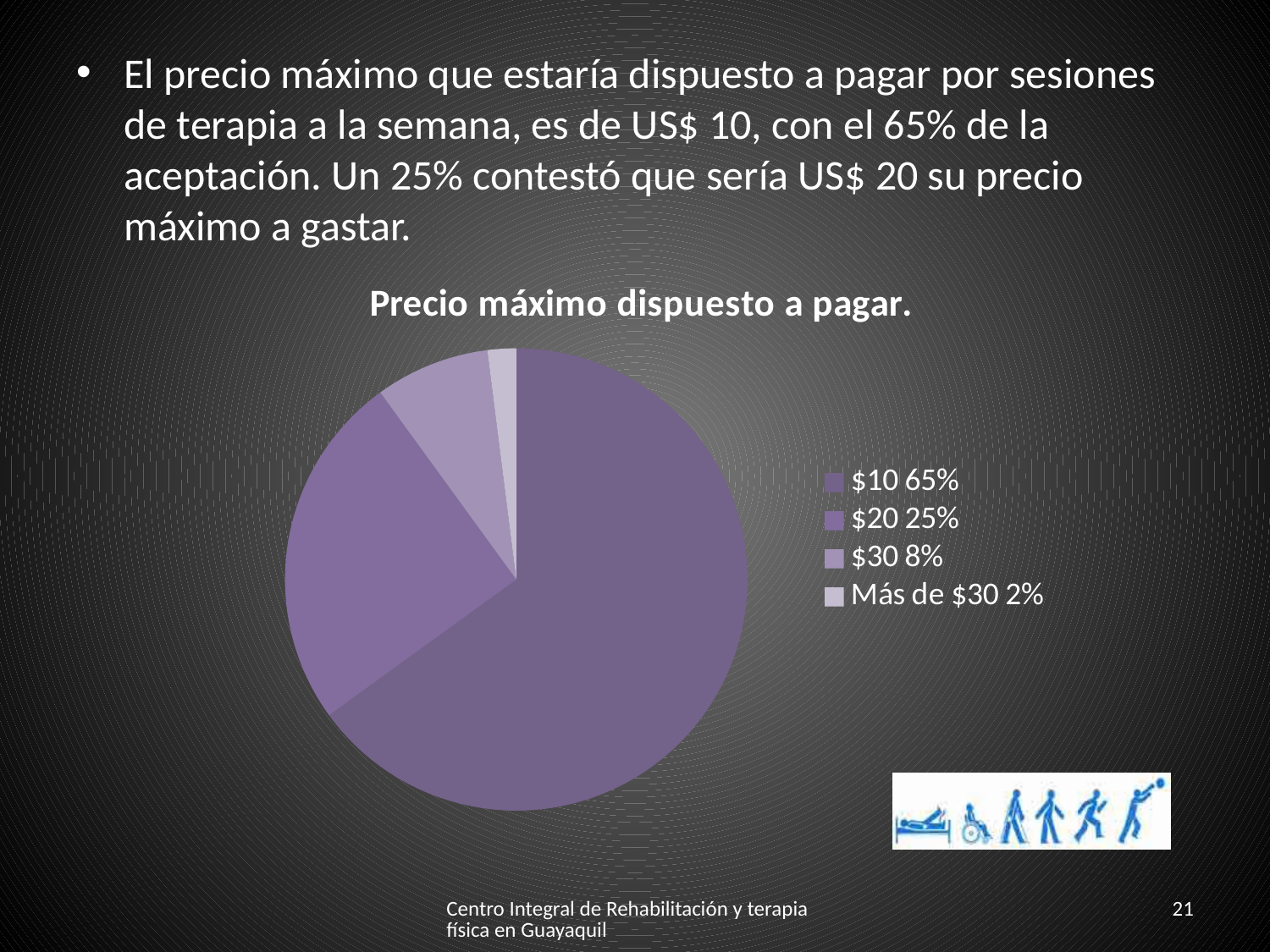
What kind of chart is shown on the slide? pie chart How many entries does the legend list? 4 What is the difference in percentage points between the $10 slice and the $20 slice? 40 What share of the pie does the $30 slice represent? 8% Which category has the largest slice of the pie? $10 What is the title of the chart? Precio máximo dispuesto a pagar. What share of the pie does the 'Más de $30' slice represent? 2% Which category has the smallest slice of the pie? Más de $30 Which slice is larger, $30 or Más de $30? $30 What share of the pie does the $20 slice represent? 25% How many slices does the pie chart have? 4